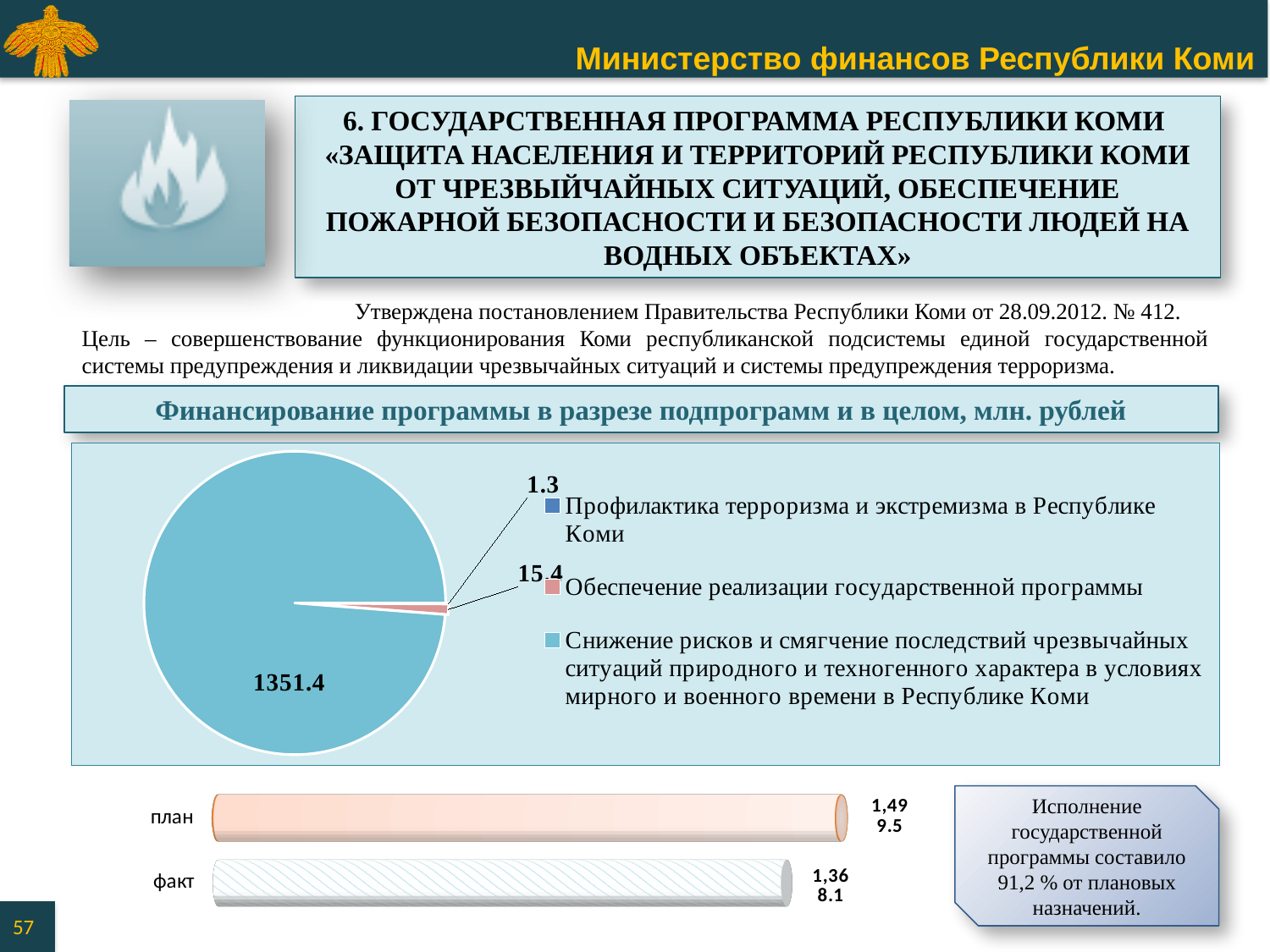
In the bar chart at the bottom of the slide, what is the difference between «план» and «факт»? 131.4 How many slices does the pie chart have? 3 In the pie chart, what is the difference between the values for «Обеспечение реализации государственной программы» and «Профилактика терроризма и экстремизма в Республике Коми»? 14.1 In the bar chart at the bottom of the slide, which is larger, «план» or «факт»? план What type of chart is the upper chart on the slide? Pie chart In the pie chart, what is the value for «Снижение рисков и смягчение последствий чрезвычайных ситуаций природного и техногенного характера в условиях мирного и военного времени в Республике Коми»? 1351.4 In the bar chart at the bottom of the slide, what is the value for «факт»? 1,368.1 In the pie chart, what is the value for «Профилактика терроризма и экстремизма в Республике Коми»? 1.3 In the pie chart, what is the value for «Обеспечение реализации государственной программы»? 15.4 In the bar chart at the bottom of the slide, what is the value for «план»? 1,499.5 In the pie chart, which subprogram has the largest slice? Снижение рисков и смягчение последствий чрезвычайных ситуаций природного и техногенного характера в условиях мирного и военного времени в Республике Коми In the pie chart, which subprogram has the smallest slice? Профилактика терроризма и экстремизма в Республике Коми